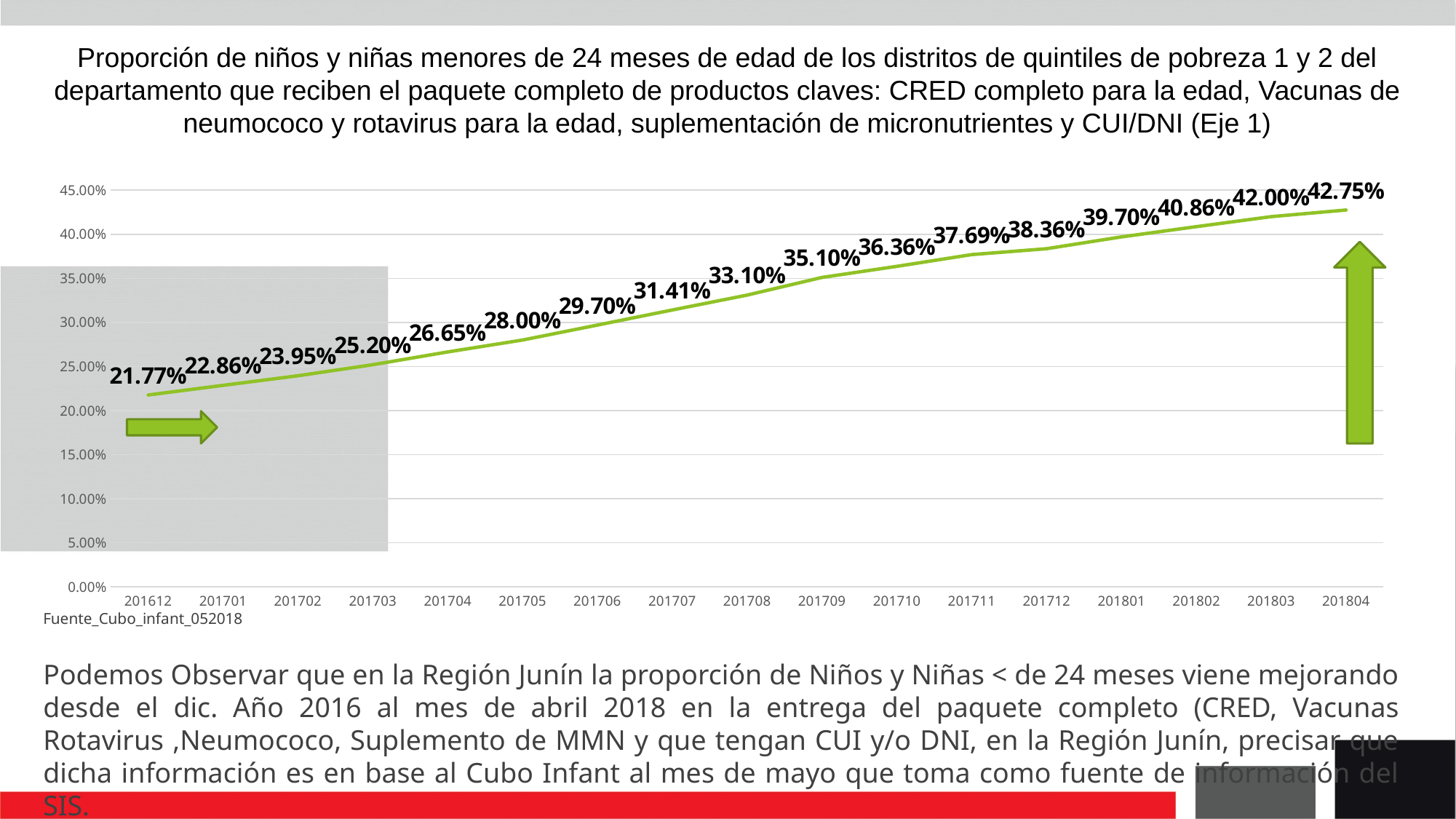
What type of chart is shown on the slide? line chart How many data points are plotted on the line? 17 What is the value for 201804? 42.75% What is the difference between the values for 201709 and 201708? 2.00% What is the difference between the values for 201804 and 201612? 20.98% Which is larger, the value for 201801 or the value for 201705? 201801 Which period has the lowest value? 201612 Do the values rise or fall from 201612 to 201804? rise Which period has the highest value? 201804 What is the value for 201612? 21.77% What is the value for 201712? 38.36% What is the value for 201707? 31.41%